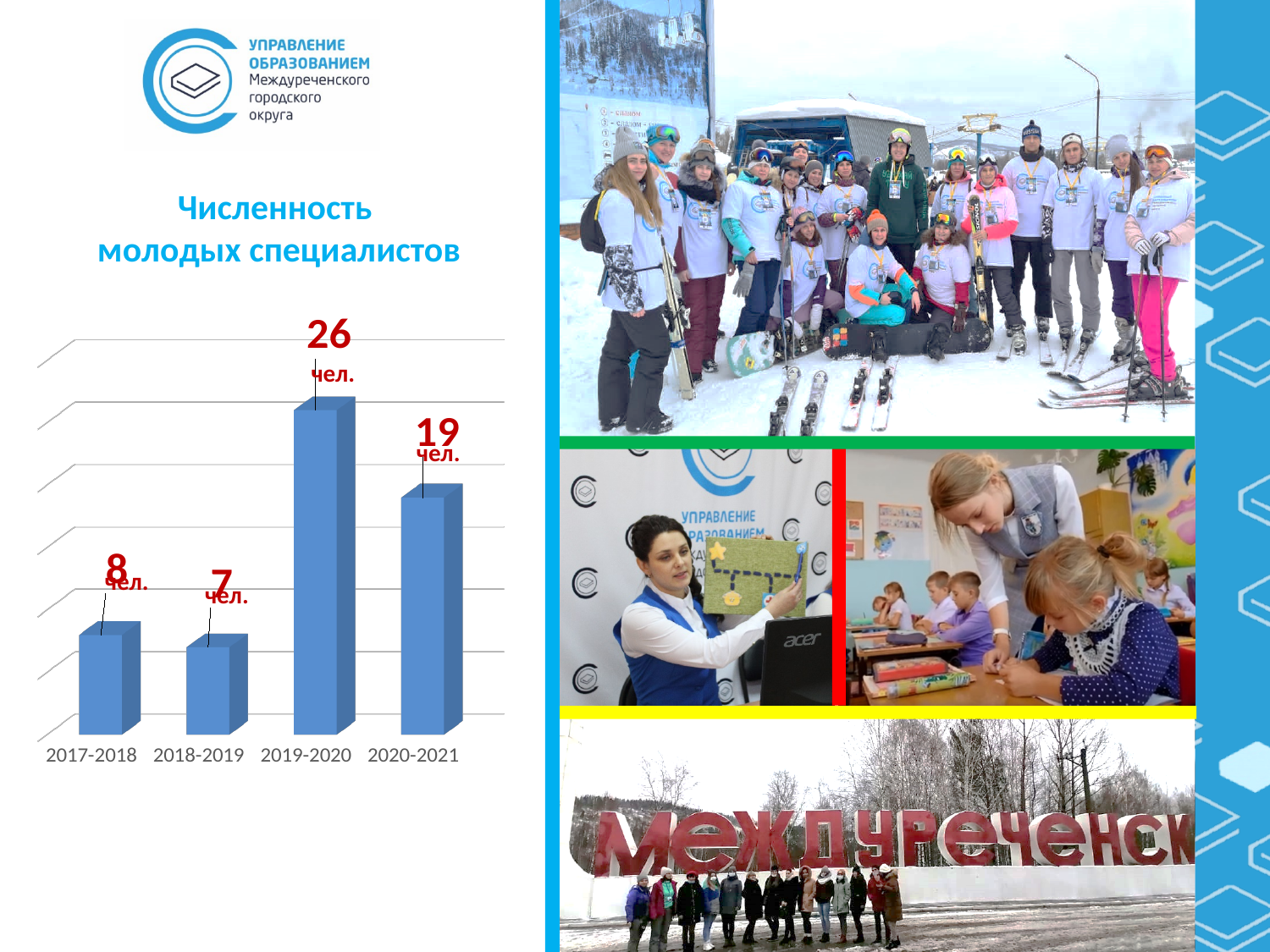
How many periods (categories) are shown on the x axis of the chart? 4 What is the difference between the values for 2017-2018 and 2018-2019? 1 What is the value for 2018-2019 in the chart? 7 чел. What is the value for 2017-2018 in the chart? 8 чел. Which period has the lowest number of young specialists? 2018-2019 What is the value for 2020-2021 in the chart? 19 чел. What kind of chart is shown on the slide? Bar chart Which period has the highest number of young specialists? 2019-2020 Which is larger, the value for 2020-2021 or the value for 2017-2018? 2020-2021 What is the value for 2019-2020 in the chart? 26 чел. What is the difference between the values for 2019-2020 and 2020-2021? 7 What is the title of the chart? Численность молодых специалистов